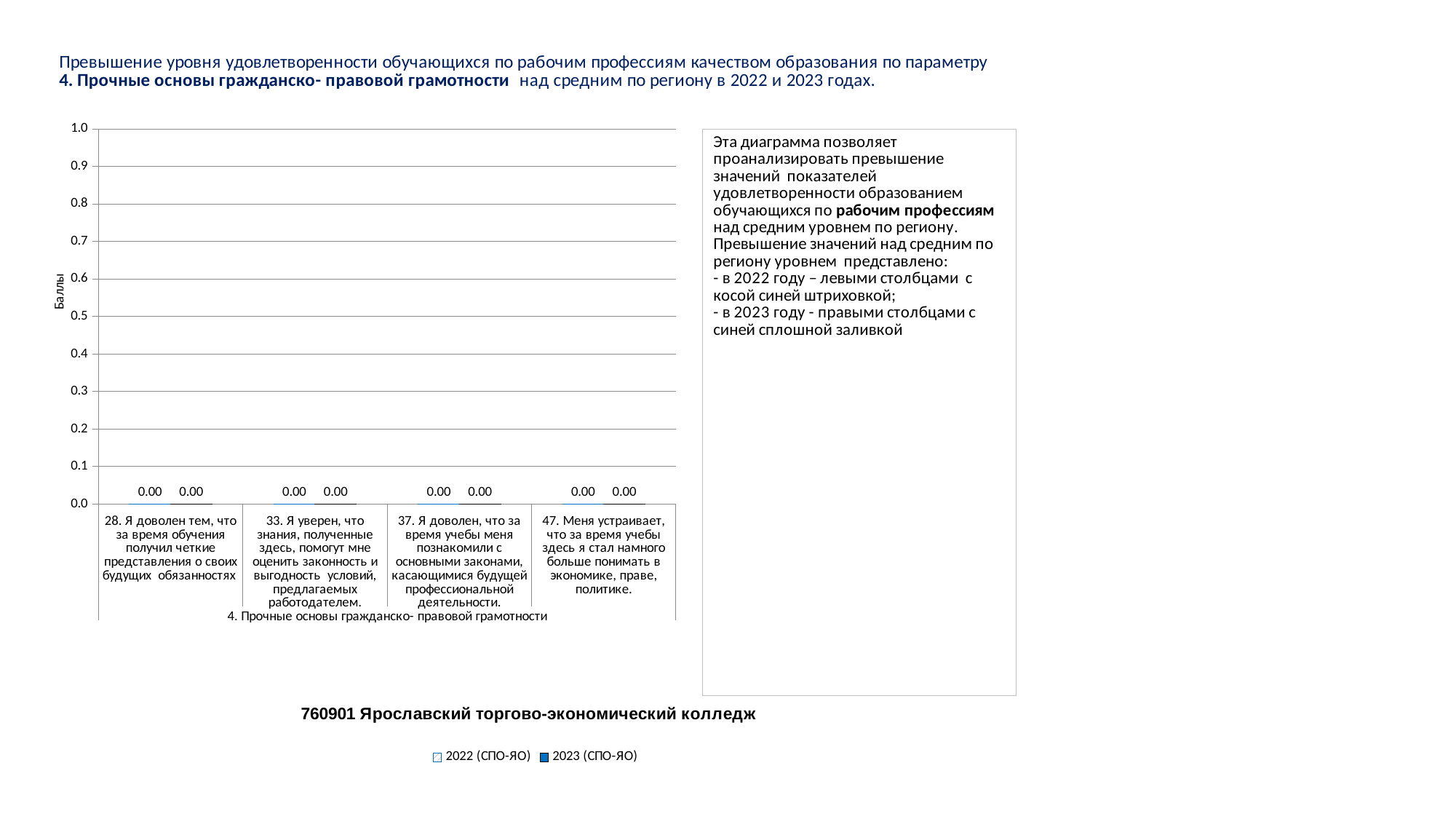
How many categories are shown on the x axis of the chart? 4 Do the 2022 (СПО-ЯО) values rise, fall, or stay flat across the categories along the x axis? stay flat What is the value for 2023 (СПО-ЯО) for category 47 (Меня устраивает, что за время учебы здесь я стал намного больше понимать в экономике, праве, политике)? 0.00 How many series does the legend list? 2 What is the value for 2022 (СПО-ЯО) for category 28 (Я доволен тем, что за время обучения получил четкие представления о своих будущих обязанностях)? 0.00 What is the difference between the 2022 (СПО-ЯО) and 2023 (СПО-ЯО) values for category 28? 0.00 What type of chart is shown on the slide? bar chart What is the label of the vertical axis of the chart? Баллы Is the value for 2023 (СПО-ЯО) for category 37 greater or less than 0.1? less What is the value for 2023 (СПО-ЯО) for category 33 (Я уверен, что знания, полученные здесь, помогут мне оценить законность и выгодность условий, предлагаемых работодателем)? 0.00 What are the two legend entries of the chart? 2022 (СПО-ЯО) and 2023 (СПО-ЯО) What is the value for 2022 (СПО-ЯО) for category 37 (Я доволен, что за время учебы меня познакомили с основными законами, касающимися будущей профессиональной деятельности)? 0.00